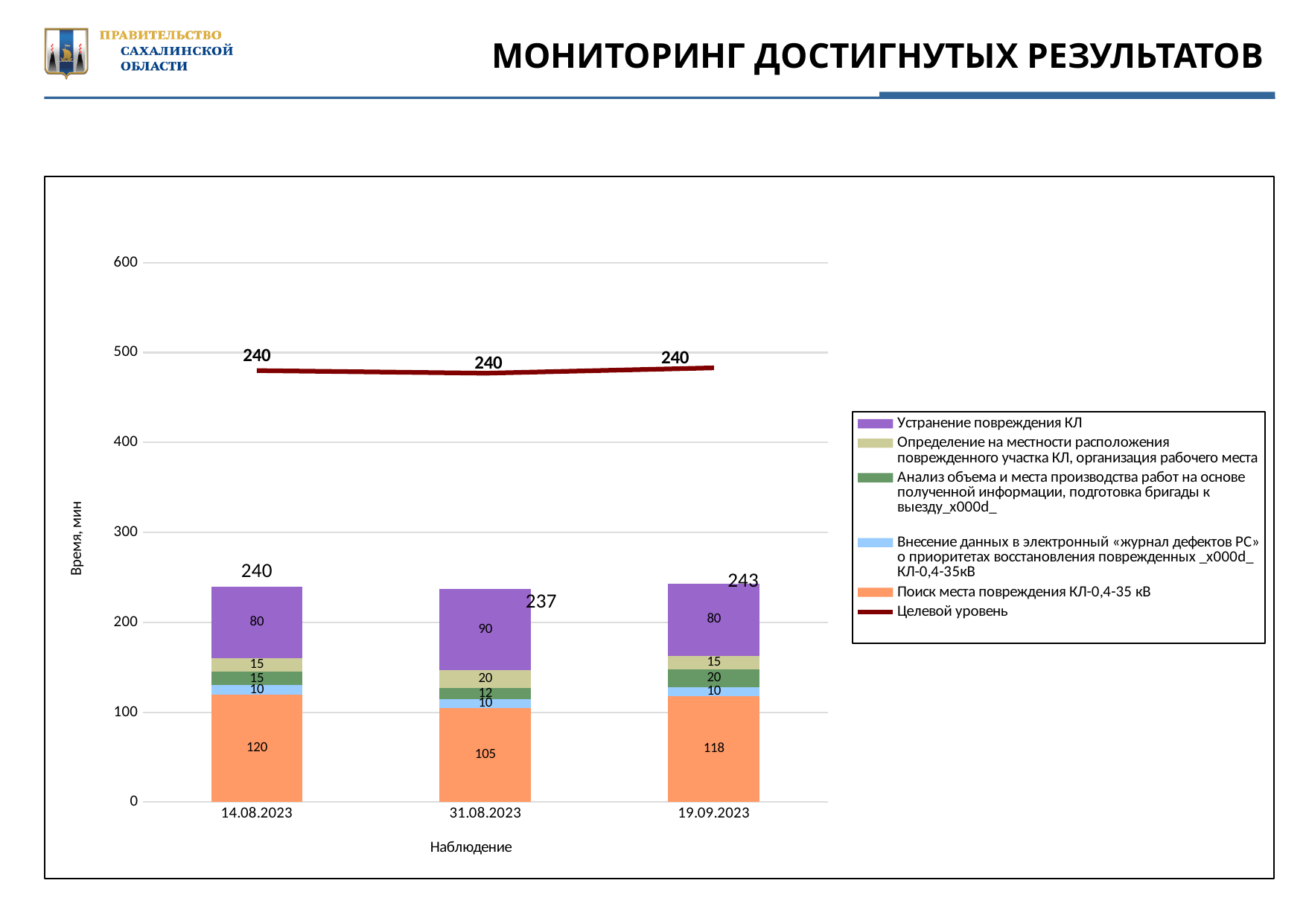
What is the value of 'Поиск места повреждения КЛ-0,4-35 кВ' for 31.08.2023? 105 What is the value of 'Устранение повреждения КЛ' for 31.08.2023? 90 Is the 'Устранение повреждения КЛ' value larger for 31.08.2023 or for 19.09.2023? 31.08.2023 How many series does the legend list? 6 Which observation date has the lowest stacked bar total? 31.08.2023 What is the difference between the 'Поиск места повреждения КЛ-0,4-35 кВ' values for 14.08.2023 and 31.08.2023? 15 What is the total of the stacked bar for 31.08.2023? 237 What is the total of the stacked bar for 19.09.2023? 243 How many observation dates are shown on the x axis? 3 What is the labelled value of the 'Целевой уровень' line at 14.08.2023? 240 Which observation date has the highest value for 'Поиск места повреждения КЛ-0,4-35 кВ'? 14.08.2023 What is the label of the y axis? Время, мин